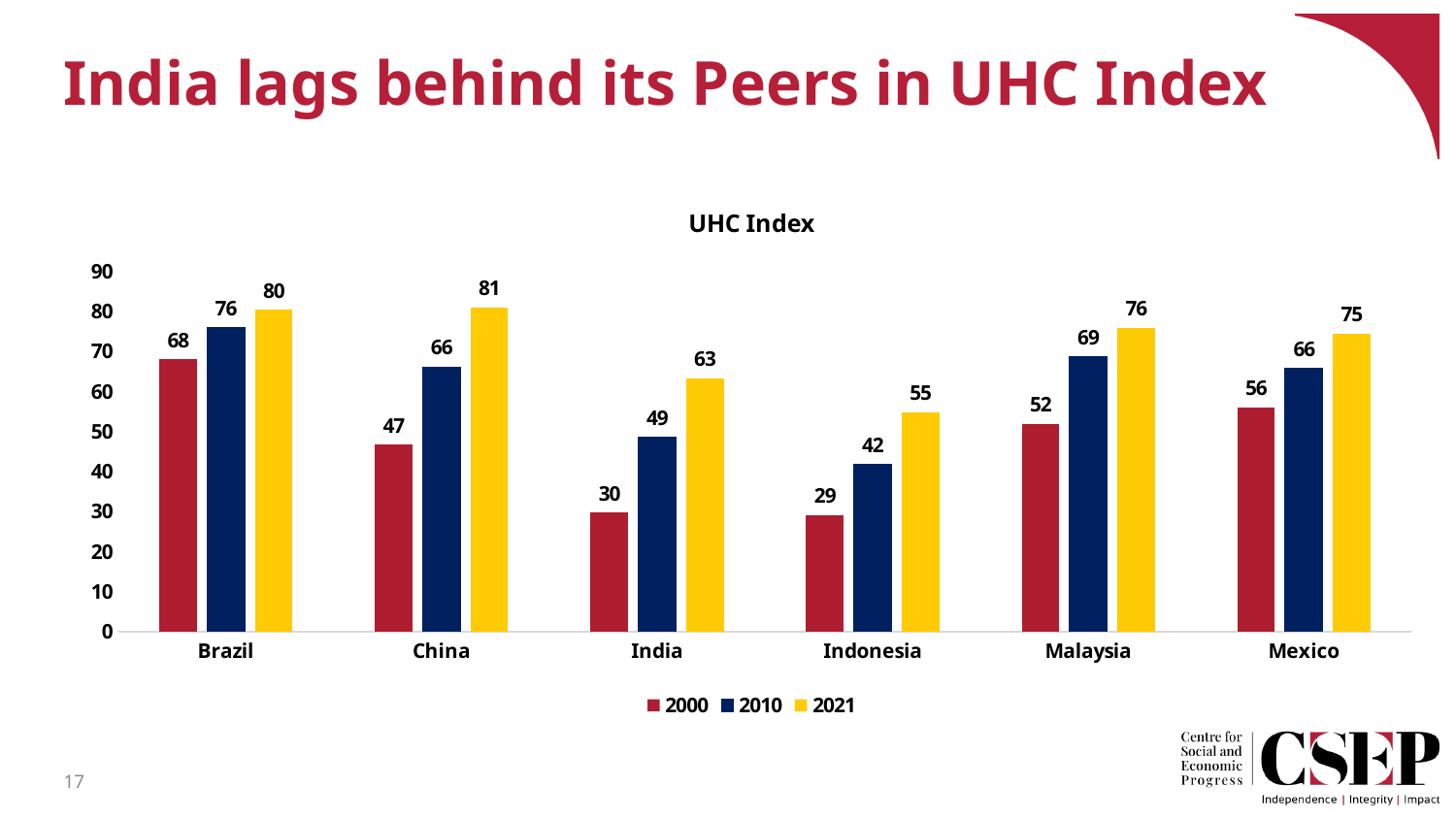
What kind of chart is shown on the slide? Bar chart What is the UHC Index value for Brazil in 2000? 68 What is the difference between China's UHC Index in 2021 and in 2000? 34 What is the UHC Index value for Malaysia in 2010? 69 Which country has the highest UHC Index value in 2021? China How many series does the legend list? 3 Which is larger: Mexico's UHC Index in 2021 or Malaysia's UHC Index in 2021? Malaysia's UHC Index in 2021 What is the title of the chart? UHC Index Which country has the lowest UHC Index value in 2000? Indonesia What is the UHC Index value for India in 2021? 63 How many countries are shown on the x axis of the chart? 6 Does India's UHC Index rise or fall from 2000 to 2021? Rise